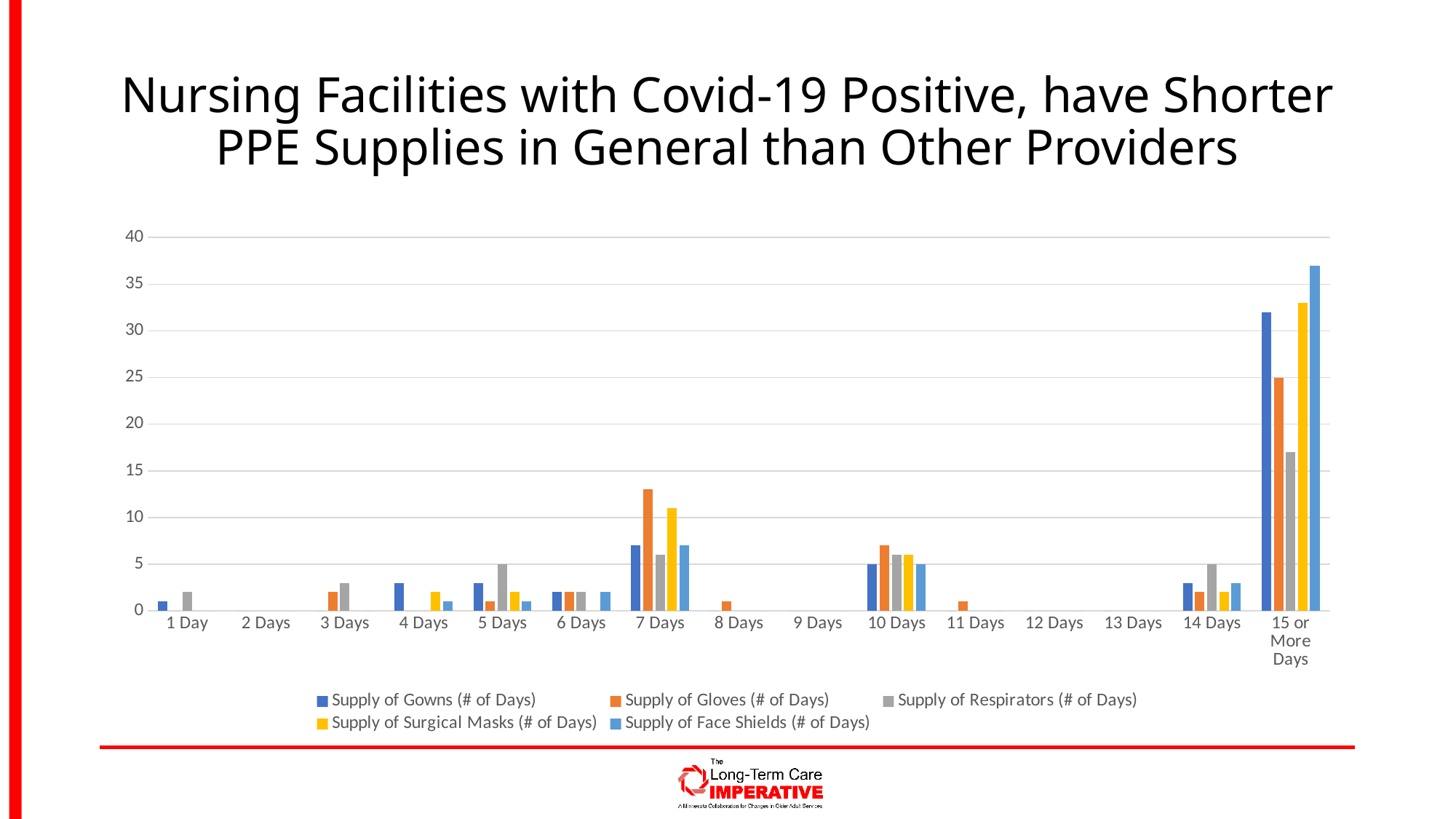
At 7 Days, which is larger: Supply of Gloves (# of Days) or Supply of Gowns (# of Days)? Supply of Gloves (# of Days) What kind of chart is shown on the slide? bar chart What is the value for Supply of Respirators (# of Days) at 5 Days? 5 Is the value for Supply of Gloves (# of Days) at 7 Days greater or less than 10? greater Is the value for Supply of Face Shields (# of Days) at 15 or More Days greater or less than 35? greater Is the value for Supply of Gowns (# of Days) at 15 or More Days greater or less than 30? greater At 15 or More Days, which is larger: Supply of Face Shields (# of Days) or Supply of Surgical Masks (# of Days)? Supply of Face Shields (# of Days) How many series does the legend list? 5 How many categories are shown along the x axis? 15 What colour represents Supply of Gloves (# of Days) in the legend? orange Which category has the highest value for Supply of Face Shields (# of Days)? 15 or More Days